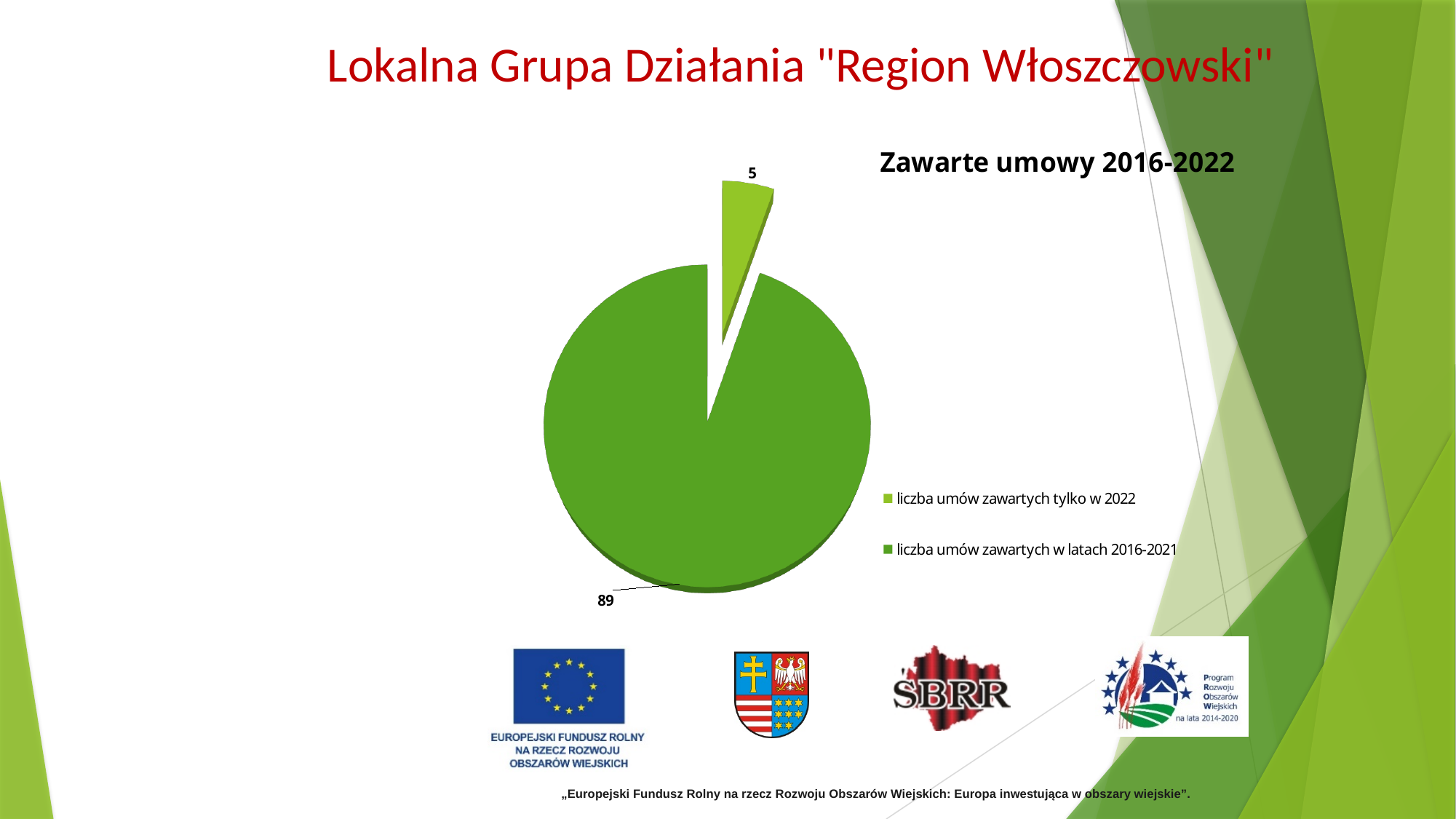
What is the value for 'liczba umów zawartych w latach 2016-2021'? 89 Which is larger: the value for 'liczba umów zawartych tylko w 2022' or for 'liczba umów zawartych w latach 2016-2021'? liczba umów zawartych w latach 2016-2021 How many entries does the legend of the pie chart list? 2 What is the difference between the number of contracts concluded in 2016-2021 and those concluded only in 2022? 84 Which category has the largest slice in the pie chart? liczba umów zawartych w latach 2016-2021 How many slices does the pie chart have? 2 What is the value for 'liczba umów zawartych tylko w 2022'? 5 What is the title of the pie chart? Zawarte umowy 2016-2022 What is the total of the two values shown in the pie chart? 94 Which legend entry is shown in the lighter green colour? liczba umów zawartych tylko w 2022 Which category has the smallest slice in the pie chart? liczba umów zawartych tylko w 2022 What type of chart is shown on the slide? pie chart